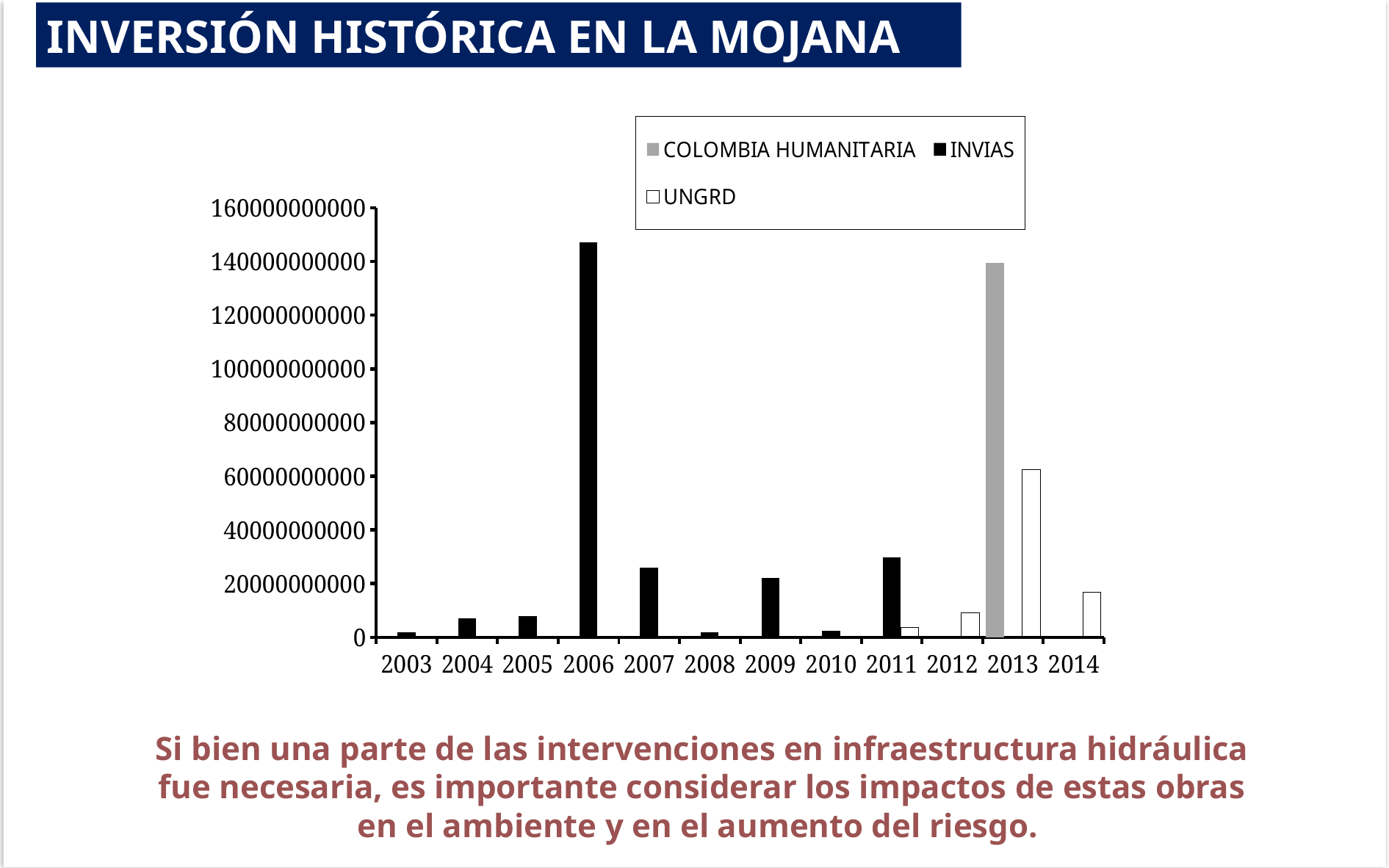
How many years are shown on the x axis? 12 Which series has the tallest bar in 2013? COLOMBIA HUMANITARIA What colour are the INVIAS bars? black In which year is the UNGRD bar the tallest? 2013 What kind of chart is shown on the slide? bar chart Which is larger, the UNGRD value for 2013 or the UNGRD value for 2014? 2013 Is the INVIAS value for 2011 greater or less than 20000000000? greater How many series does the legend list? 3 In which year is the INVIAS bar the tallest? 2006 Is the COLOMBIA HUMANITARIA value for 2013 greater or less than 120000000000? greater Is the INVIAS value for 2006 greater or less than 140000000000? greater